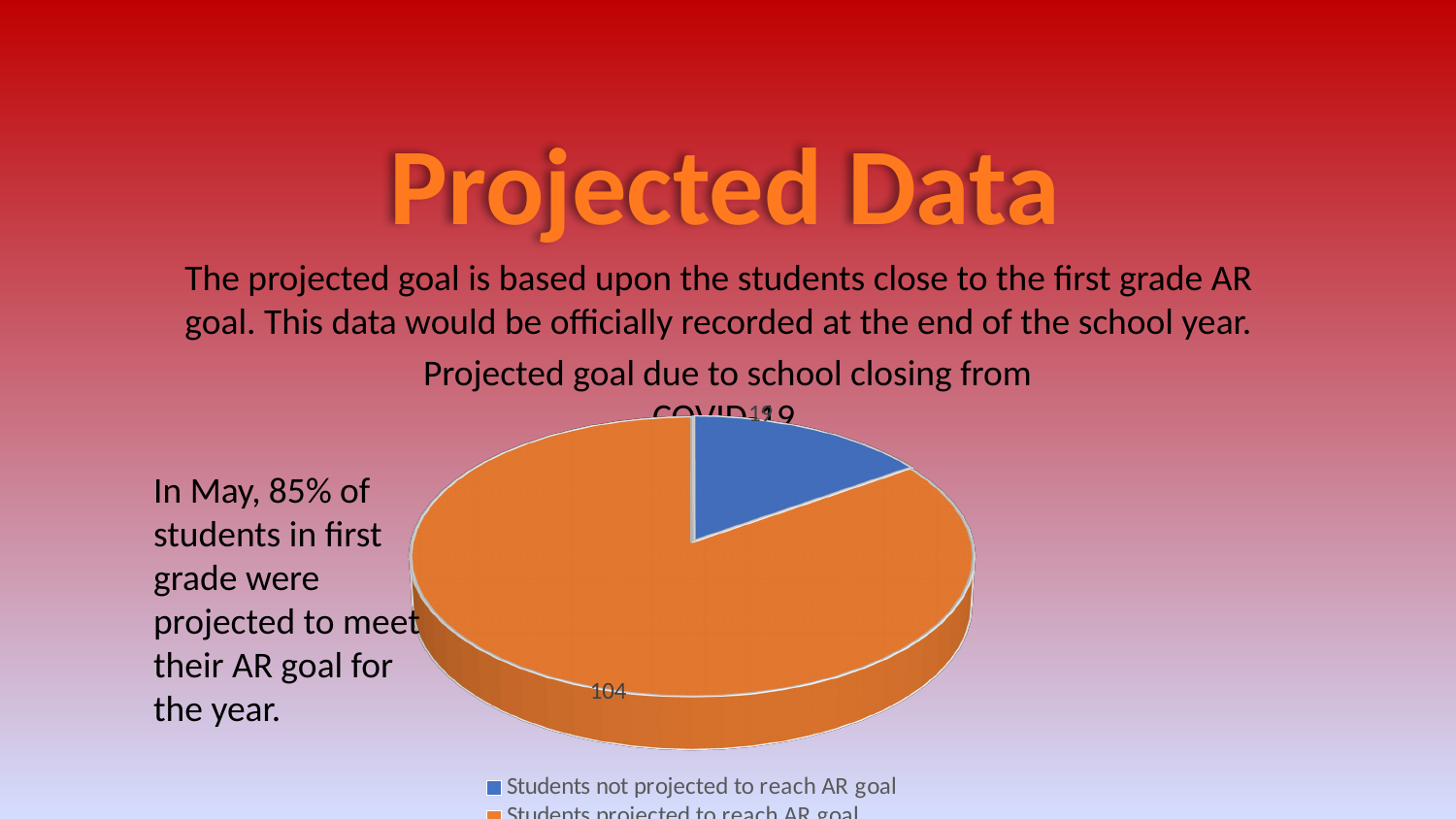
Which is larger: Students projected to reach AR goal or Students not projected to reach AR goal? Students projected to reach AR goal What colour is the slice for Students not projected to reach AR goal? Blue Which category has the largest slice of the pie? Students projected to reach AR goal How many entries does the legend list? 2 What is the difference between the number of students projected to reach the AR goal and those not projected to reach it? 85 What is the title of the pie chart? Projected goal due to school closing from COVID-19 What is the total number of students represented in the pie chart? 123 Which category has the smallest slice of the pie? Students not projected to reach AR goal What is the value for Students projected to reach AR goal? 104 What type of chart is shown on the slide? Pie chart What is the value for Students not projected to reach AR goal? 19 How many slices does the pie chart have? 2